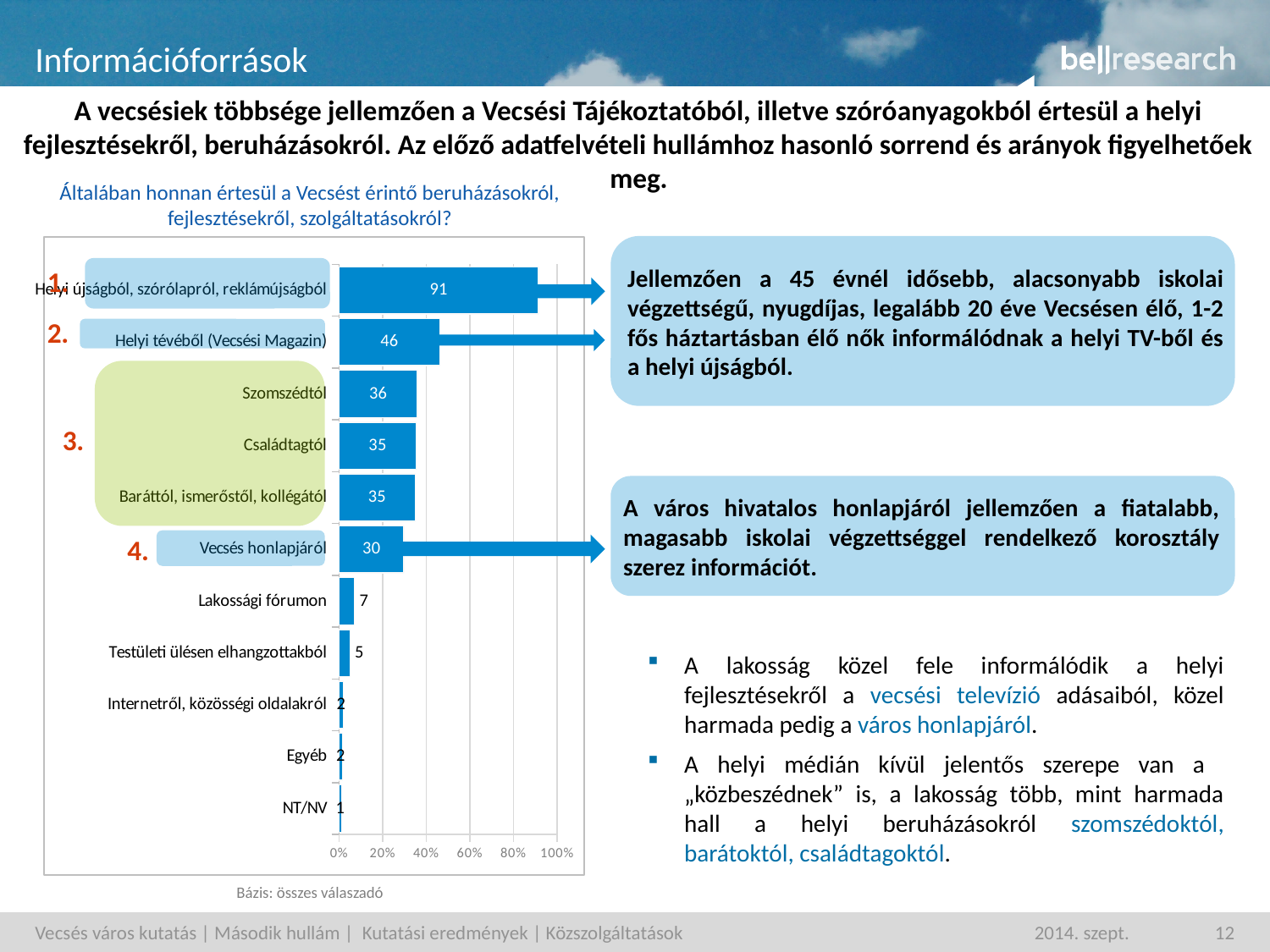
Which category has the highest value in the chart? Helyi újságból, szórólapról, reklámújságból What value is shown for "Lakossági fórumon"? 7 What type of chart is shown on the slide? bar chart How many categories are shown in the chart? 11 Which has a larger value, "Szomszédtól" or "Testületi ülésen elhangzottakból"? Szomszédtól What value is shown for "Vecsés honlapjáról"? 30 What is the difference between the values for "Szomszédtól" and "Vecsés honlapjáról"? 6 What is the difference between the values for "Helyi újságból, szórólapról, reklámújságból" and "Helyi tévéből (Vecsési Magazin)"? 45 What is the title of the chart? Általában honnan értesül a Vecsést érintő beruházásokról, fejlesztésekről, szolgáltatásokról? What value is shown for "Helyi tévéből (Vecsési Magazin)"? 46 Is the value for "Helyi újságból, szórólapról, reklámújságból" greater or less than 80%? greater Which category has the lowest value in the chart? NT/NV